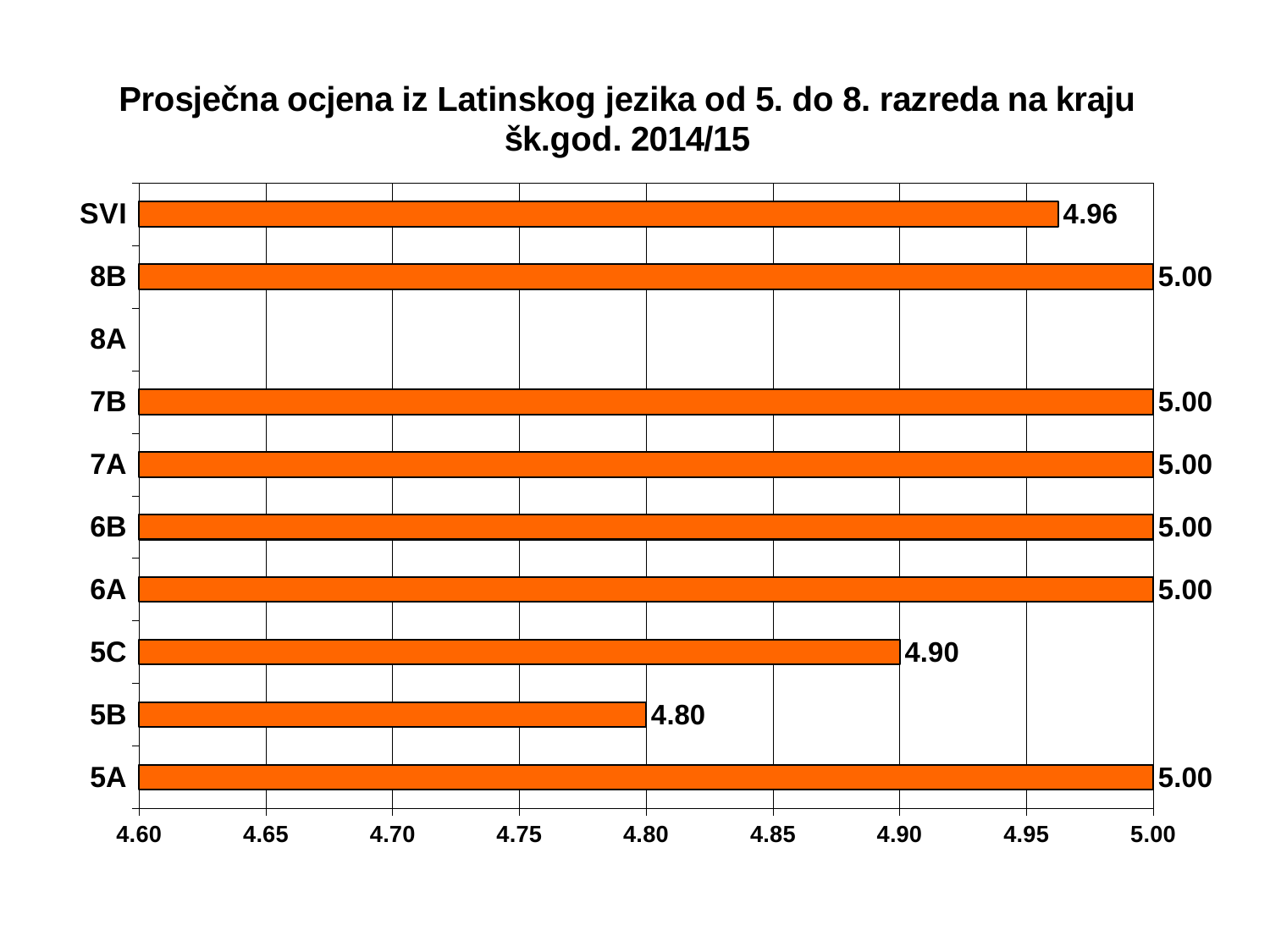
Which category has the lowest value among those with a bar shown? 5B Which category has no bar shown? 8A What kind of chart is shown on the slide? bar chart Is the value for SVI greater or less than 4.90? greater What is the value for 5C? 4.90 What colour are the bars in the chart? orange Which is larger, the value for 5C or the value for 5B? 5C What is the difference between the values for 5C and 5B? 0.10 What is the value for SVI? 4.96 What is the value for 5B? 4.80 How many categories are listed on the vertical axis? 10 What is the difference between the values for 8B and SVI? 0.04